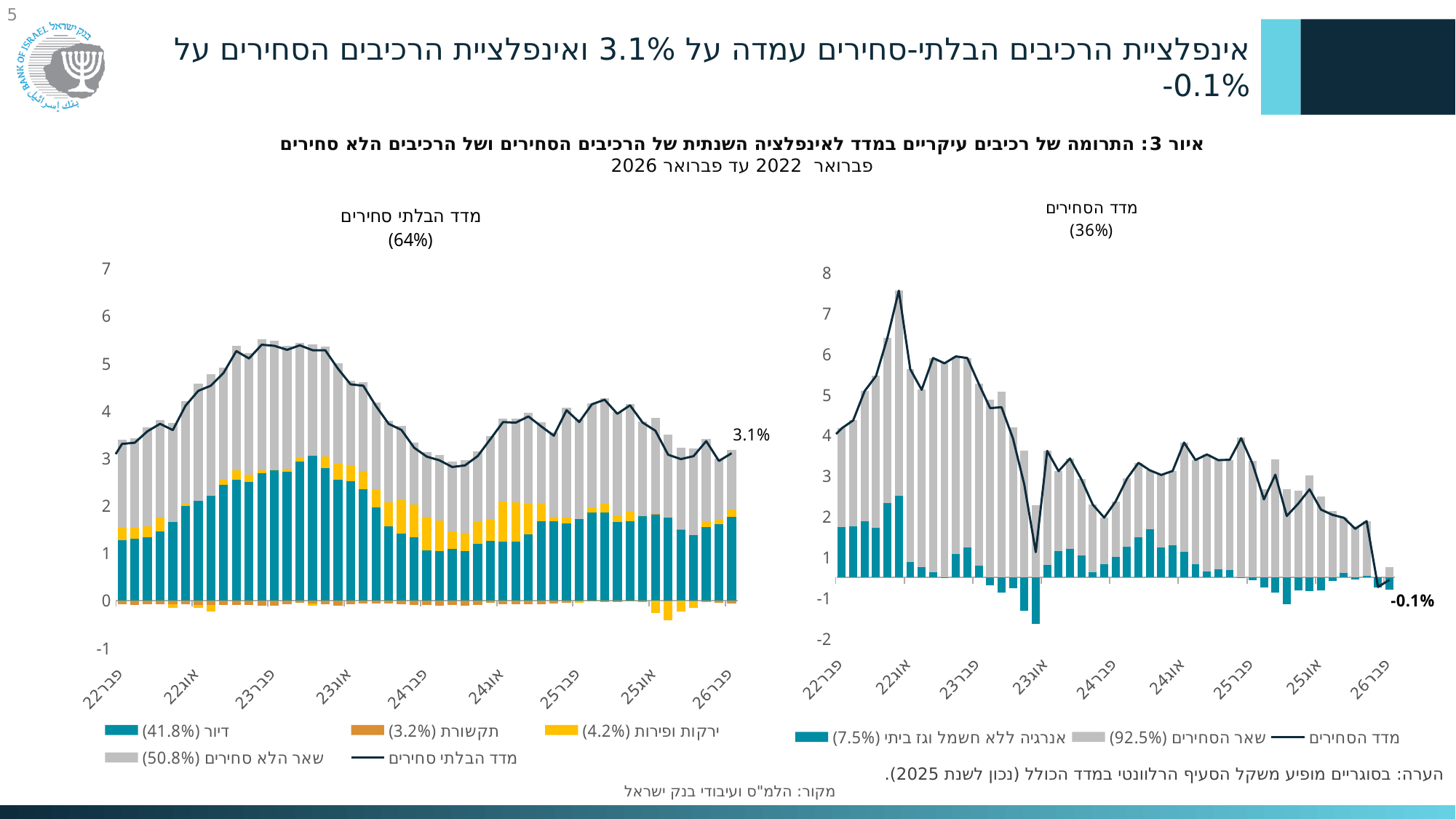
How many entries does the legend of the left chart list? 5 In the right chart, at which x-axis label does the line reach its highest point? אוג 22 How many entries does the legend of the right chart list? 3 In the left chart (מדד הבלתי סחירים), what is the value printed at the end of the line for February 2026? 3.1% Which is larger at February 2026: the non-tradable index (left chart) or the tradable index (right chart)? The non-tradable index (left chart), 3.1% What weight is shown in the left chart's legend for דיור? 41.8% What kind of chart is the left chart? A stacked bar chart with a line What is the difference between the February 2026 values of the left chart (3.1%) and the right chart (-0.1%)? 3.2 percentage points In the right chart (מדד הסחירים), what is the value printed at the end of the line for February 2026? -0.1% In the right chart, does the line generally rise or fall from אוג 22 to פבר 26? fall